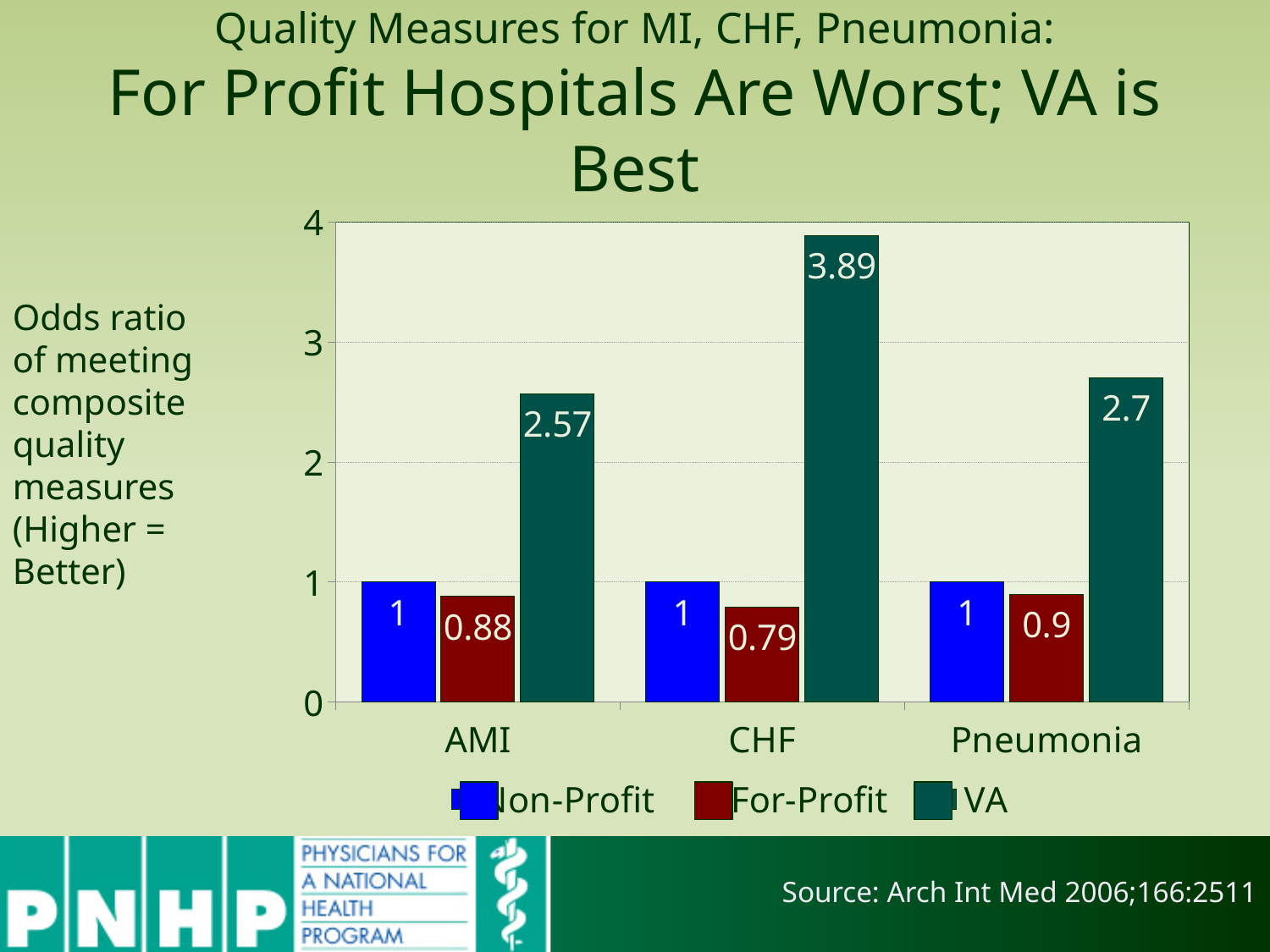
What is the VA odds ratio for CHF? 3.89 Which is larger, the VA odds ratio for CHF or the VA odds ratio for Pneumonia? CHF Which condition has the highest VA odds ratio? CHF What is the For-Profit odds ratio for AMI? 0.88 What is the VA odds ratio for Pneumonia? 2.7 How many series does the legend list? 3 What is the difference between the VA and Non-Profit odds ratios for AMI? 1.57 Is the VA odds ratio for AMI greater or less than 2? greater What kind of chart is shown on the slide? bar chart What is the For-Profit odds ratio for CHF? 0.79 Which condition has the lowest For-Profit odds ratio? CHF How many conditions are shown on the x axis? 3